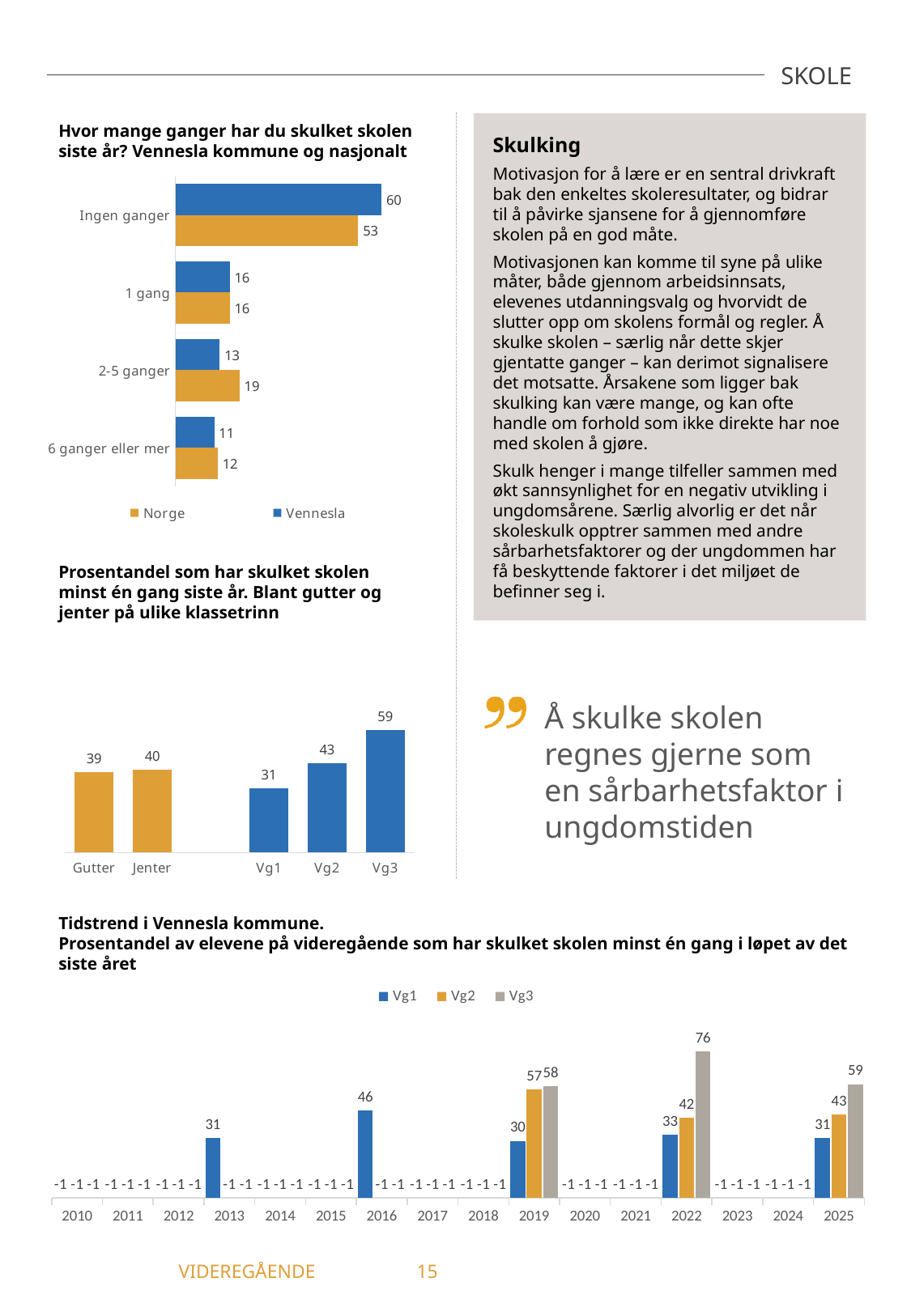
In the chart 'Hvor mange ganger har du skulket skolen siste år?', what kind of chart is it? Bar chart In the chart 'Hvor mange ganger har du skulket skolen siste år?', what is the value for Norge in the category '2-5 ganger'? 19 In the chart 'Hvor mange ganger har du skulket skolen siste år?', what is the value for Vennesla in the category 'Ingen ganger'? 60 In the chart 'Hvor mange ganger har du skulket skolen siste år?', how many series does the legend list? 2 In the chart 'Hvor mange ganger har du skulket skolen siste år?', what is the difference between the Vennesla and Norge values for 'Ingen ganger'? 7 In the chart 'Prosentandel som har skulket skolen minst én gang siste år', which category has the highest value? Vg3 In the chart 'Tidstrend i Vennesla kommune', what is the value for Vg1 in 2016? 46 In the chart 'Prosentandel som har skulket skolen minst én gang siste år', what is the value for Jenter? 40 In the chart 'Prosentandel som har skulket skolen minst én gang siste år', how many categories are shown on the x axis? 5 In the chart 'Tidstrend i Vennesla kommune', what is the difference between the Vg3 values for 2022 and 2025? 17 In the chart 'Tidstrend i Vennesla kommune', what is the value for Vg3 in 2022? 76 In the chart 'Tidstrend i Vennesla kommune', which is larger in 2019: Vg1 or Vg2? Vg2